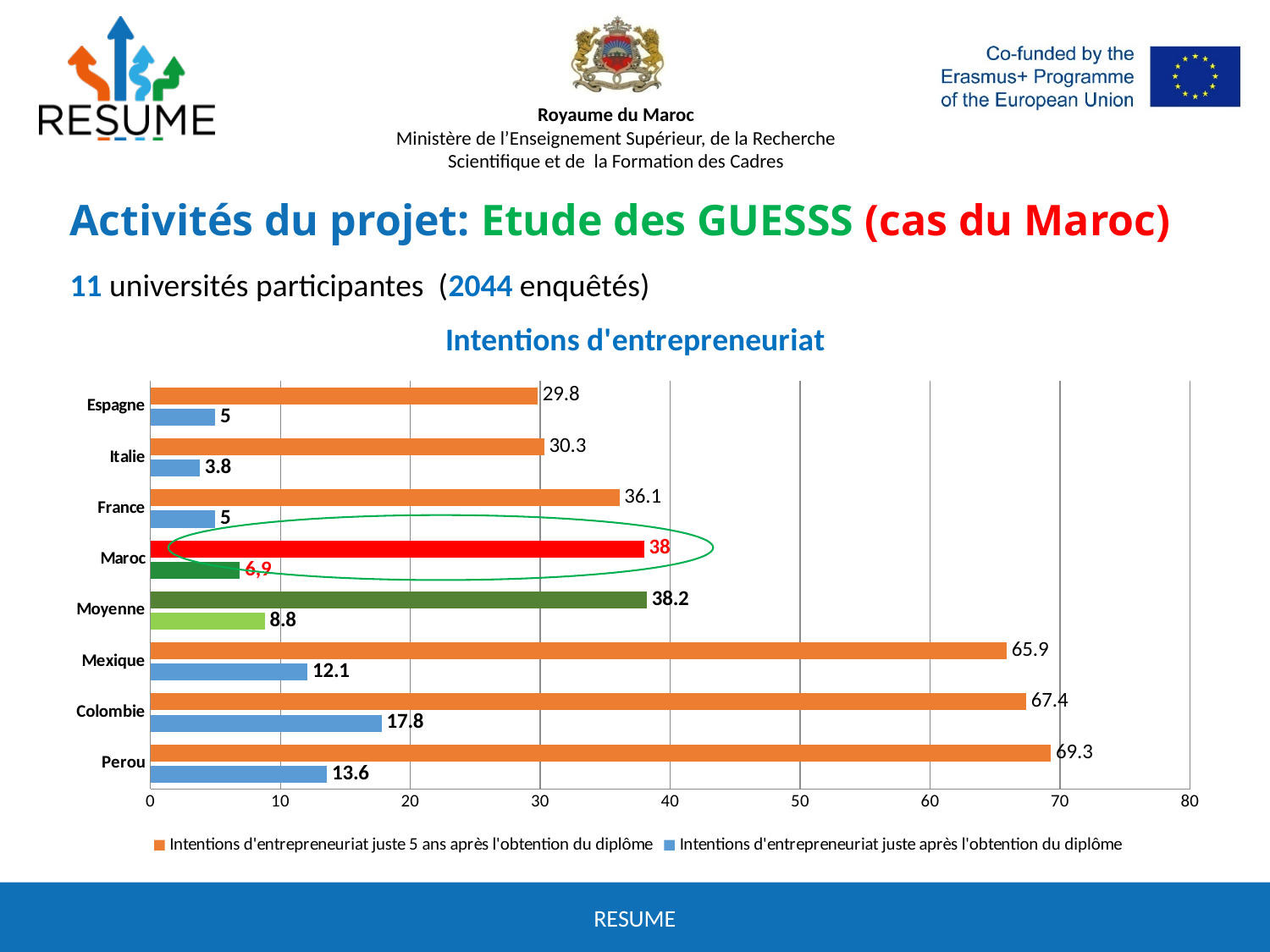
Which category has the lowest value in the series 'Intentions d'entrepreneuriat juste après l'obtention du diplôme'? Italie How many series does the chart legend list? 2 What is the difference between the values for Perou and Espagne in the series 'Intentions d'entrepreneuriat juste 5 ans après l'obtention du diplôme'? 39.5 Which category has the highest value in the series 'Intentions d'entrepreneuriat juste après l'obtention du diplôme'? Colombie What is the value for Maroc in the series 'Intentions d'entrepreneuriat juste 5 ans après l'obtention du diplôme'? 38 Which is larger: the value for Mexique or the value for France in the series 'Intentions d'entrepreneuriat juste 5 ans après l'obtention du diplôme'? Mexique Which category has the highest value in the series 'Intentions d'entrepreneuriat juste 5 ans après l'obtention du diplôme'? Perou What is the value for Moyenne in the series 'Intentions d'entrepreneuriat juste 5 ans après l'obtention du diplôme'? 38.2 How many categories are shown on the vertical axis of the chart? 8 What is the value for Colombie in the series 'Intentions d'entrepreneuriat juste après l'obtention du diplôme'? 17.8 What is the title of the chart? Intentions d'entrepreneuriat What type of chart is shown under the title 'Intentions d'entrepreneuriat'? Bar chart